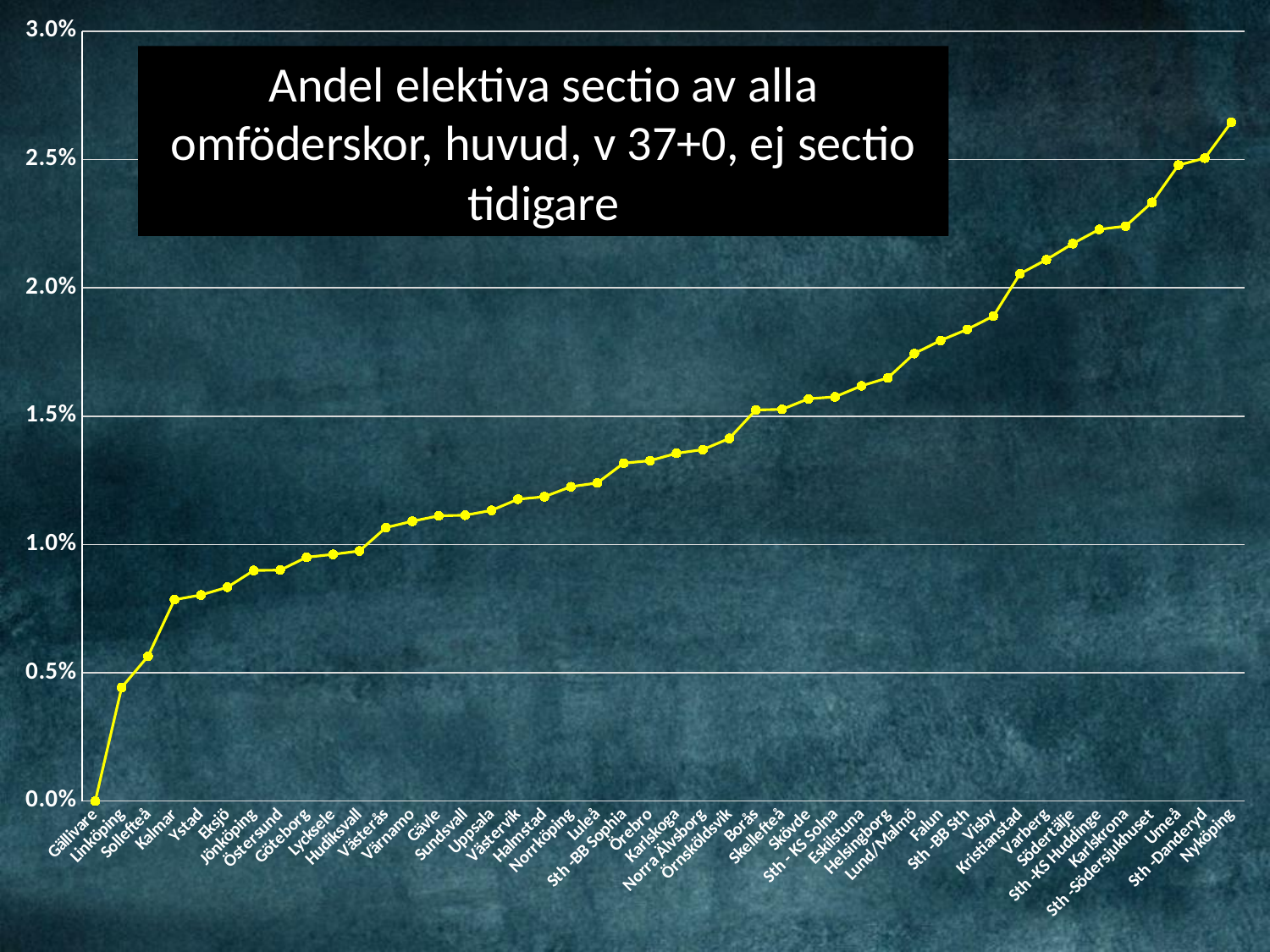
Which has the larger value, Umeå or Kalmar? Umeå Do the values rise or fall from left to right along the x axis? rise Is the value for Kalmar greater or less than 1.0%? less What is the value for Gällivare? 0.0% What is the title of the chart? Andel elektiva sectio av alla omföderskor, huvud, v 37+0, ej sectio tidigare What kind of chart is shown on the slide? line chart Is the value for Linköping greater or less than 0.5%? less Which category has the highest value? Nyköping How many categories are plotted on the x axis? 44 Is the value for Kristianstad greater or less than 2.0%? greater Which category has the lowest value? Gällivare